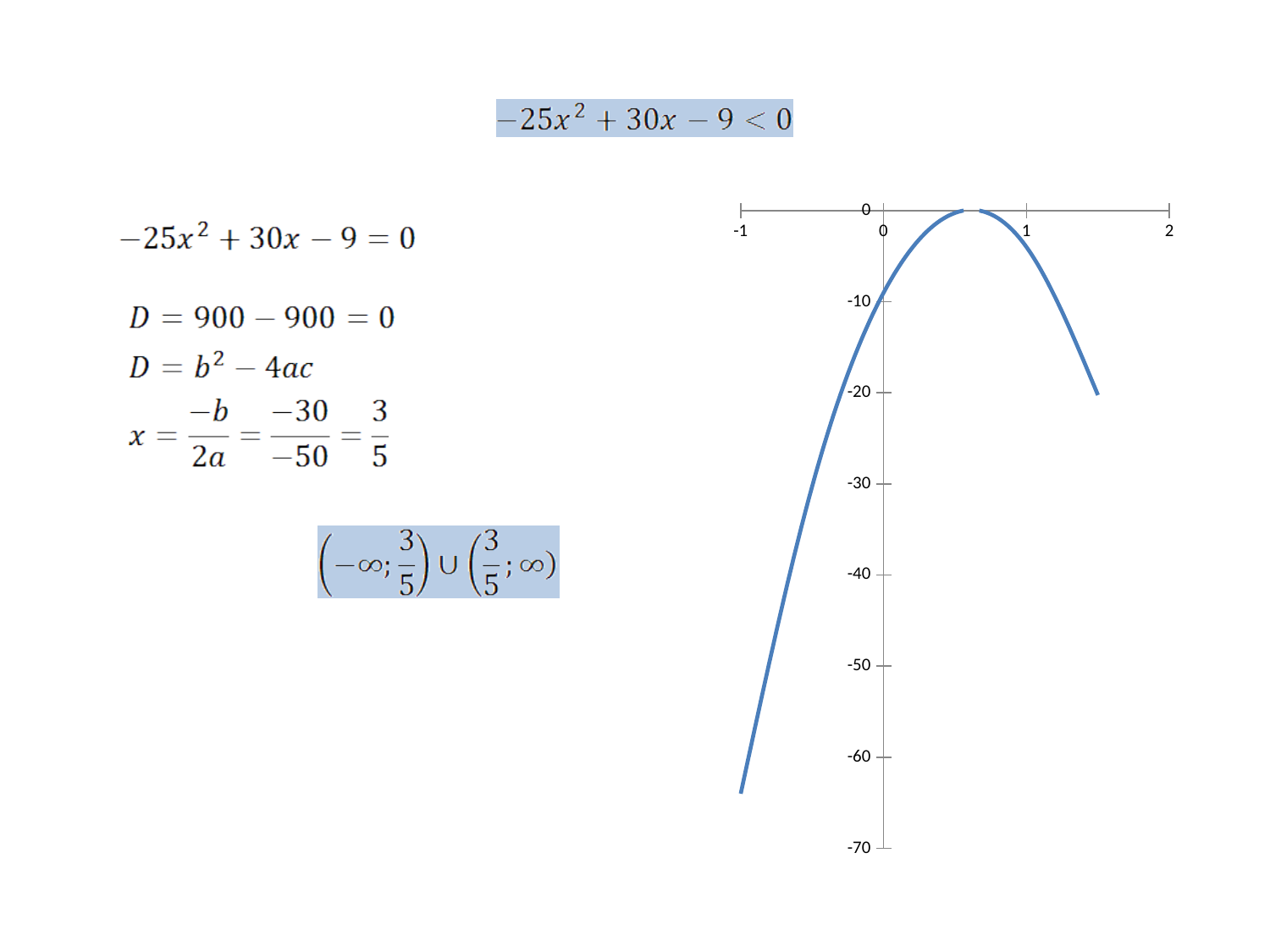
Does the curve rise or fall as x increases from 1 to 1.5? falls Does the curve rise or fall as x increases from -1 to 0? rises Is the value of the curve at x = 1 greater or less than -10? greater What is the lowest value labelled on the vertical axis of the chart? -70 What is the highest value labelled on the horizontal axis of the chart? 2 What kind of chart is shown on the slide? line chart Is the value of the curve at x = 0 greater or less than -20? greater Is the value of the curve at x = -1 greater or less than -60? less Is the value of the curve at x = -1 larger or smaller than its value at x = 1? smaller